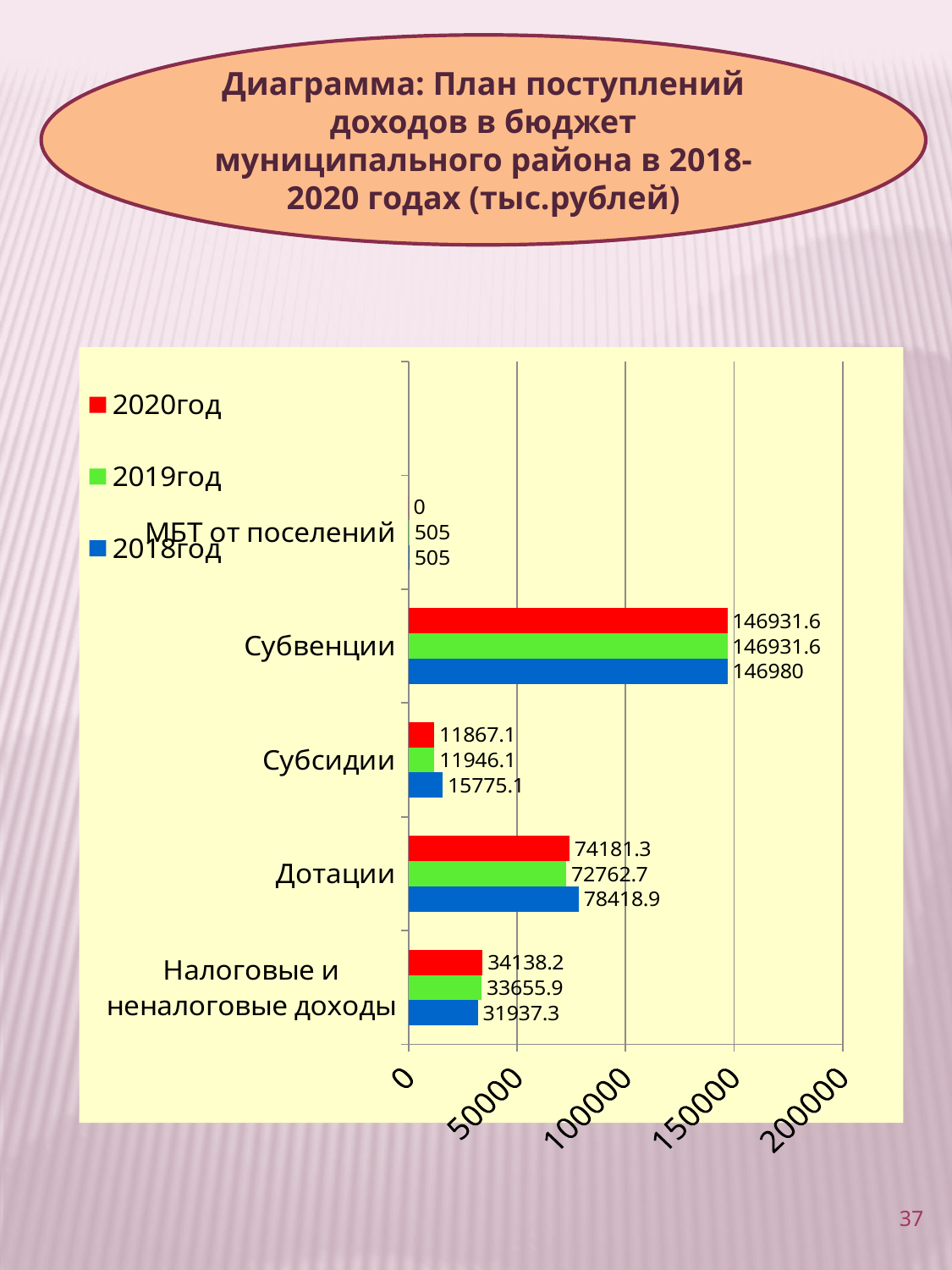
What is the value for Дотации in 2019год? 72762.7 Which series is shown in red in the legend? 2020год What is the value for Субвенции in 2018год? 146980 Which category has the highest value in 2020год? Субвенции What type of chart is shown on the slide? bar chart Which is larger for Налоговые и неналоговые доходы: the 2020год value or the 2018год value? 2020год How many series does the legend list? 3 What is the value for Налоговые и неналоговые доходы in 2018год? 31937.3 How many categories are shown on the chart? 5 Which category has the lowest value in 2019год? МБТ от поселений What is the value for Субсидии in 2020год? 11867.1 What is the difference between the 2018год and 2020год values for Дотации? 4237.6